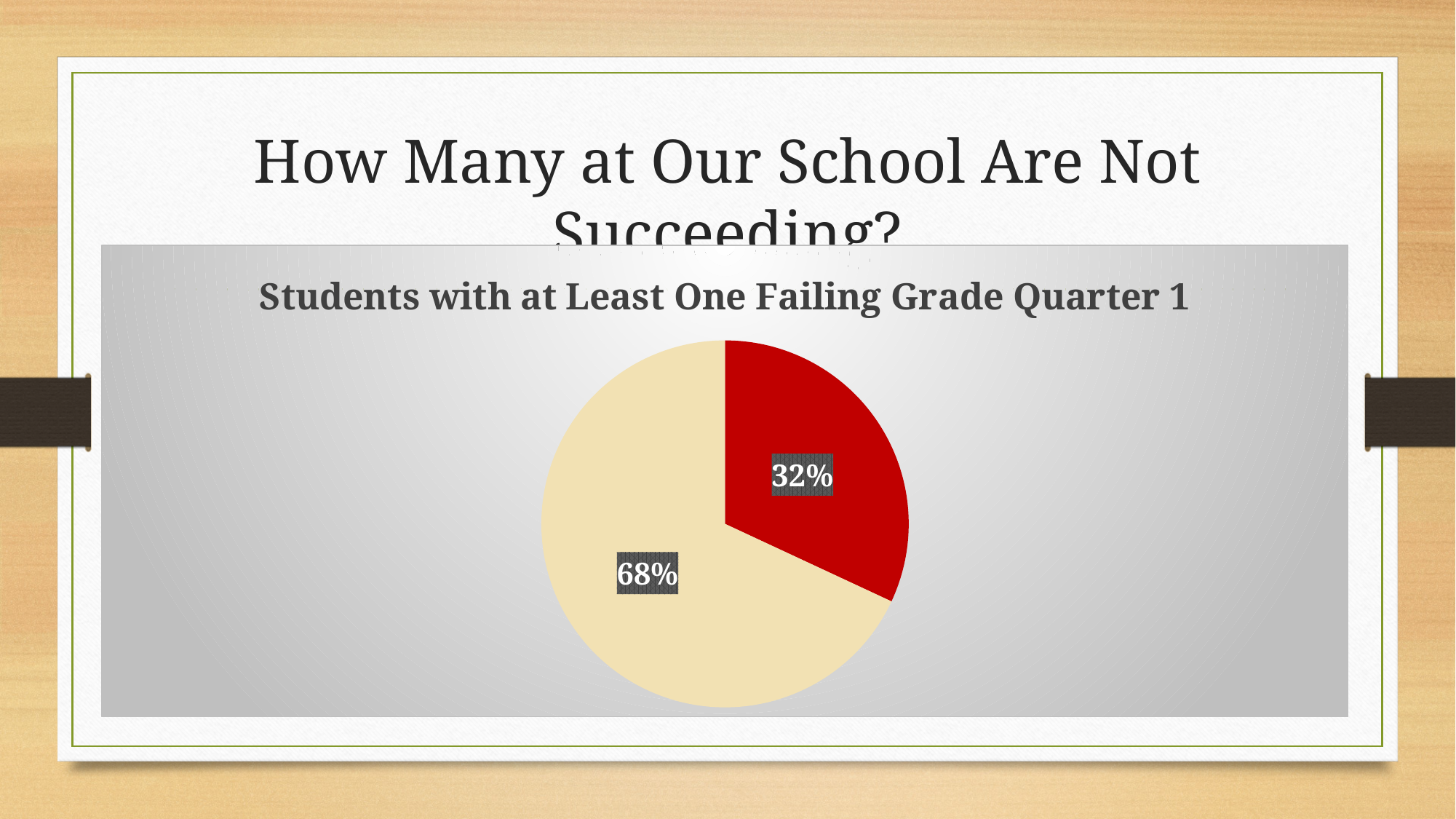
What kind of chart is shown on the slide? Pie chart Which slice of the pie is the smallest? The red slice (32%) What share of the pie does the beige slice represent? 68% What is the difference in percentage points between the beige slice and the red slice? 36 percentage points Which slice of the pie is the largest? The beige slice (68%) What is the total of the two slice percentages shown on the pie chart? 100% What colour is the slice labelled 32%? Red What is the title of the chart? Students with at Least One Failing Grade Quarter 1 Which is larger, the red slice or the beige slice? The beige slice What share of the pie does the red slice represent? 32% How many slices does the pie chart have? 2